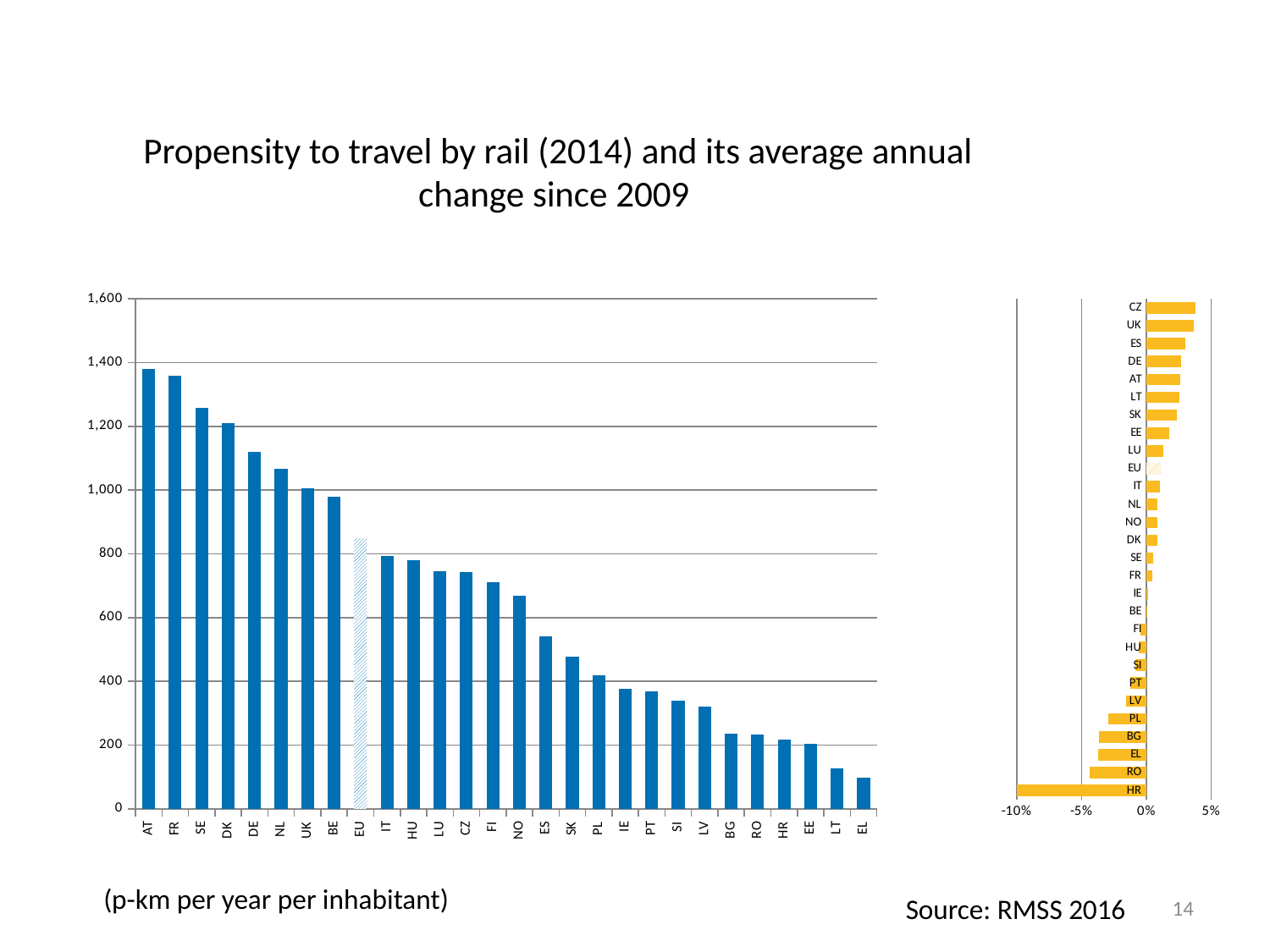
In the left chart, is the value for ES greater or less than 600? less How many categories are shown in the left chart? 28 In the left chart, is the value for LT greater or less than 200? less In the left chart, is the value for DE greater or less than 1,000? greater In the left chart, do the values rise or fall from left to right along the x axis? fall In the right chart, which category has the lowest value? HR What kind of chart is the right chart? bar chart In the left chart, which category has the lowest value? EL In the left chart, which category has the highest value? AT In the left chart, which is larger, the value for FR or the value for HU? FR